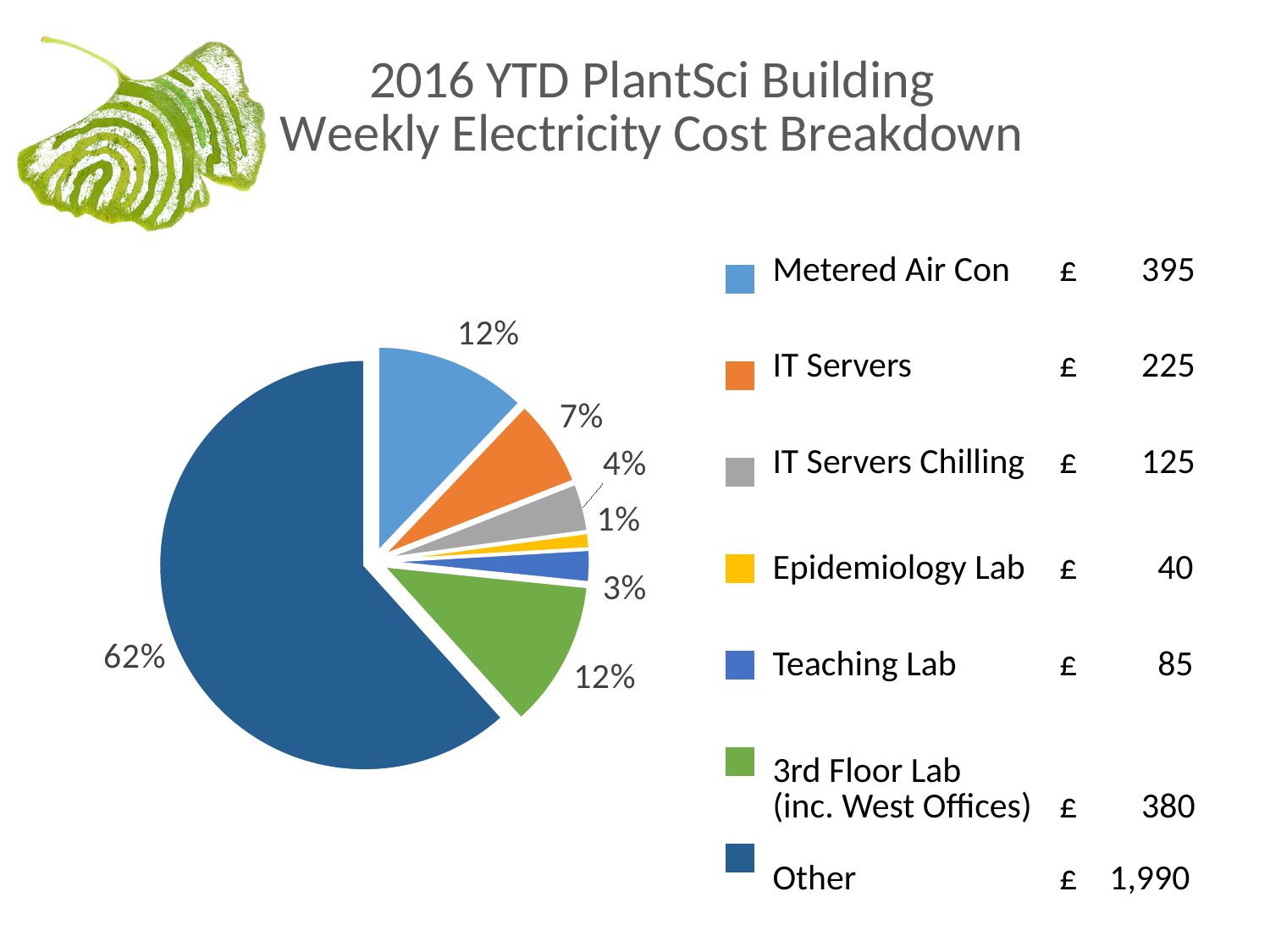
Which category has the smallest share of the pie? Epidemiology Lab What share of the pie does IT Servers represent? 7% What share of the pie does Other represent? 62% What is the weekly electricity cost for Metered Air Con? £395 What kind of chart is shown on the slide? pie chart What is the difference in weekly cost between IT Servers and IT Servers Chilling? £100 How many categories does the pie chart have? 7 Which has the larger weekly cost, IT Servers or Teaching Lab? IT Servers What colour is the slice for Teaching Lab? blue Which category has the largest share of the pie? Other What share of the pie does Epidemiology Lab represent? 1% What is the weekly electricity cost for 3rd Floor Lab (inc. West Offices)? £380